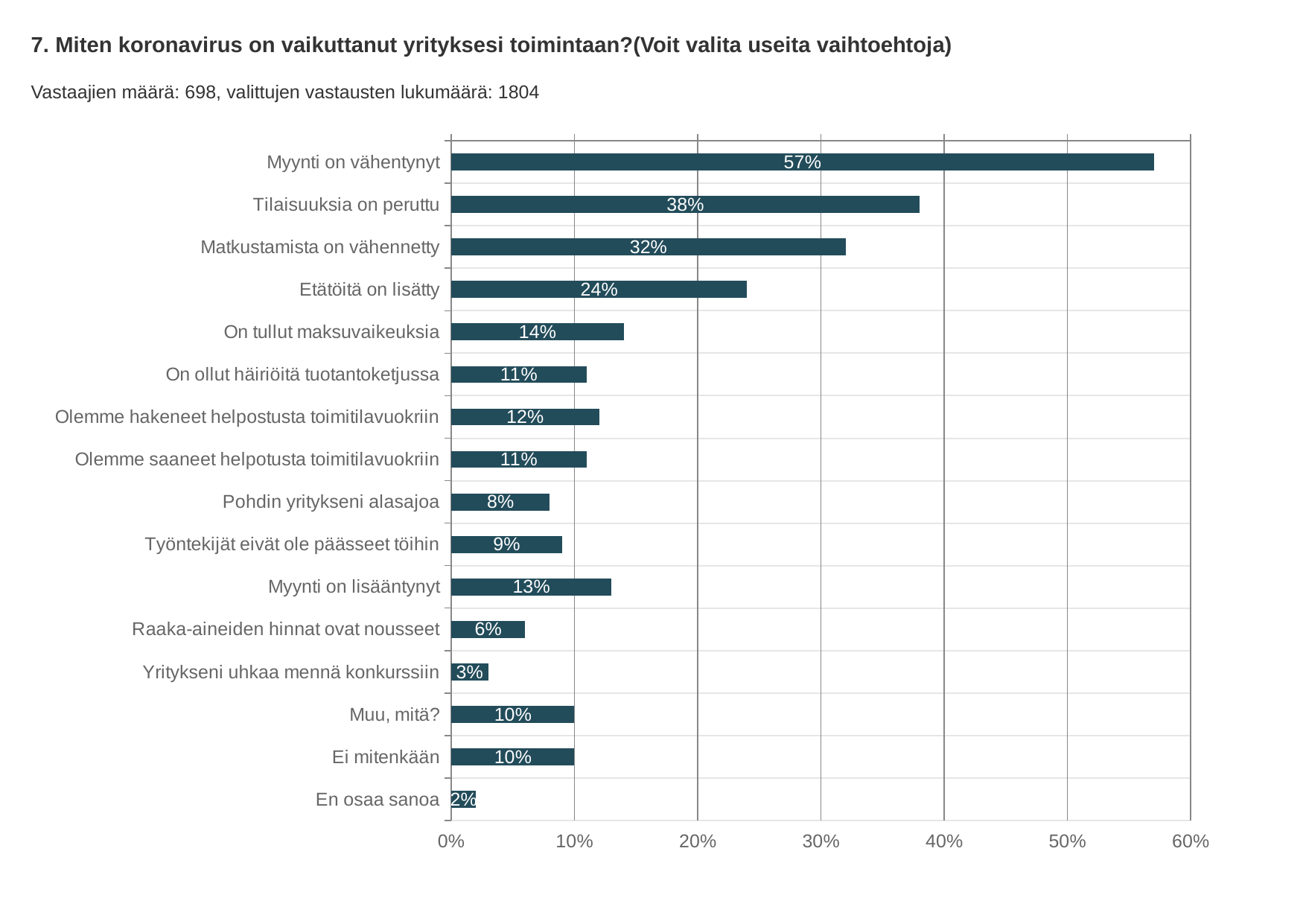
What is the value for "Yritykseni uhkaa mennä konkurssiin"? 3% Is the value for "On tullut maksuvaikeuksia" greater or less than 10%? greater What is the number of respondents (Vastaajien määrä) stated on the slide? 698 How many categories are shown in the chart? 16 What kind of chart is shown on the slide? bar chart Which is larger, "Myynti on lisääntynyt" or "Pohdin yritykseni alasajoa"? Myynti on lisääntynyt What is the value for "Myynti on vähentynyt"? 57% What is the value for "Etätöitä on lisätty"? 24% Which category has the highest value? Myynti on vähentynyt Which category has the lowest value? En osaa sanoa What is the difference between "Tilaisuuksia on peruttu" and "Matkustamista on vähennetty"? 6% What is the maximum value shown on the x axis? 60%